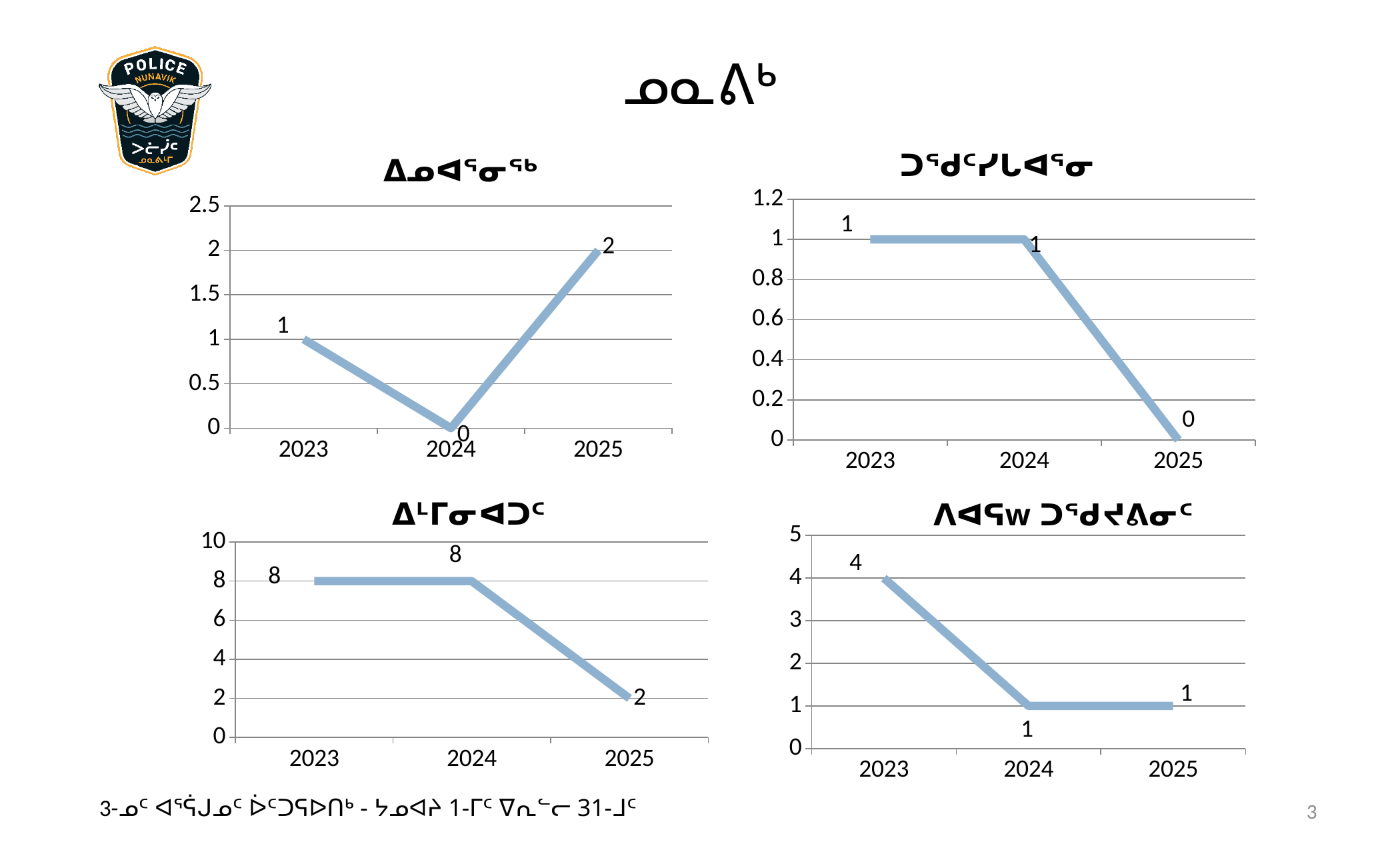
What kind of chart is the top-right chart? line chart How many years are plotted on the x axis of the bottom-left chart? 3 In the bottom-left chart, what is the difference between the values for 2024 and 2025? 6 In the top-left chart, what is the value for 2025? 2 In the bottom-left chart, is the value for 2023 greater or less than 6? greater In the bottom-right chart, which year has the highest value? 2023 In the top-left chart, which year has the lowest value? 2024 In the bottom-right chart, which is larger, the value for 2023 or the value for 2025? 2023 In the bottom-left chart, what is the value for 2024? 8 In the top-right chart, what is the difference between the values for 2023 and 2025? 1 In the bottom-right chart, what is the value for 2023? 4 In the top-right chart, what is the value for 2025? 0